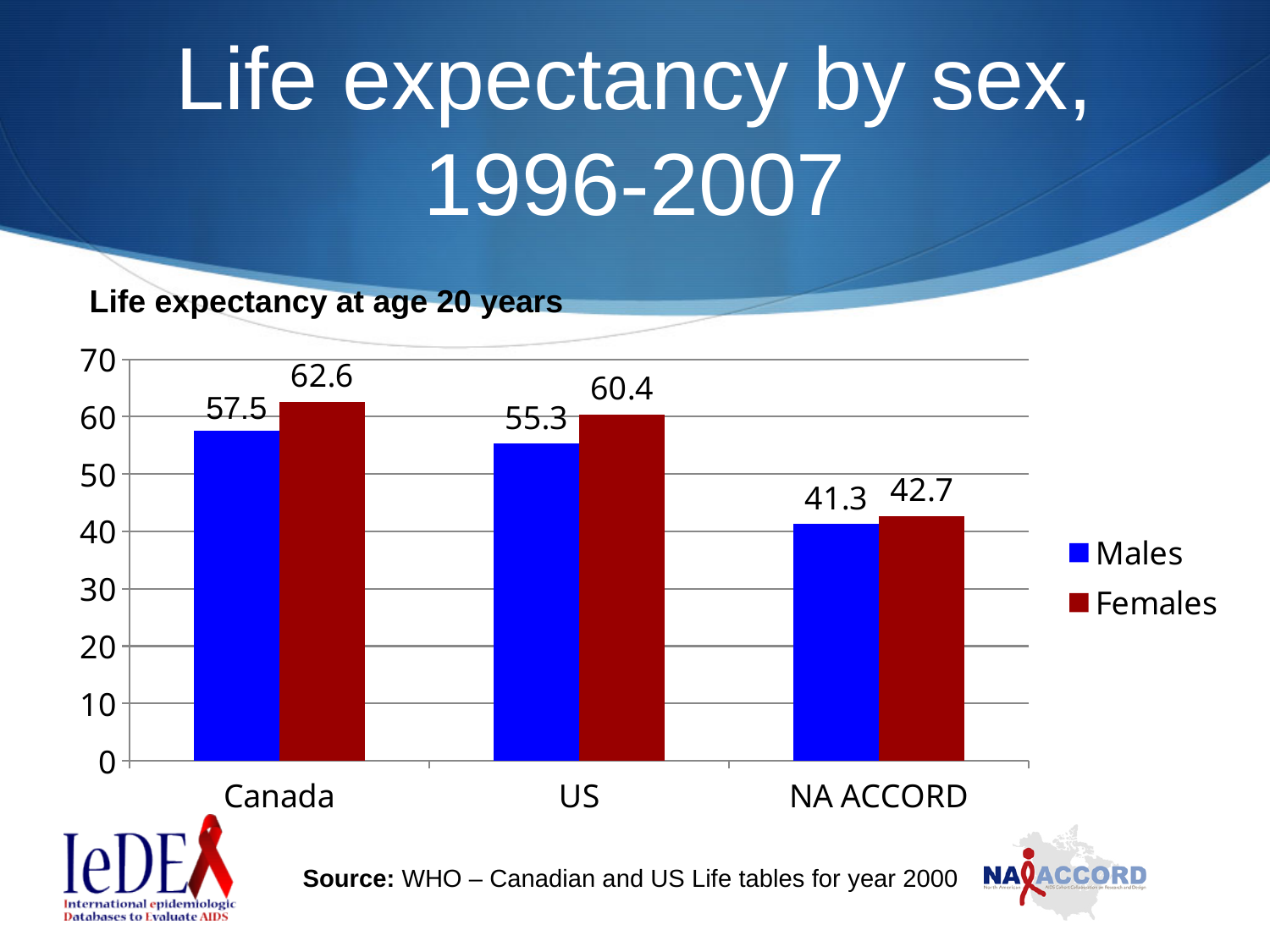
How many series does the legend list? 2 What is the life expectancy at age 20 for males in Canada? 57.5 How many categories are shown on the x axis? 3 Which is larger, the male value for the US or the male value for NA ACCORD? US Which category has the highest value for females? Canada What is the difference between the male values for Canada and the US? 2.2 Which category has the lowest value for males? NA ACCORD Is the value for females in NA ACCORD greater or less than 50? less What is the difference between the female and male values for Canada? 5.1 What kind of chart is shown on the slide? bar chart What is the life expectancy at age 20 for females in the US? 60.4 What is the value for females in NA ACCORD? 42.7